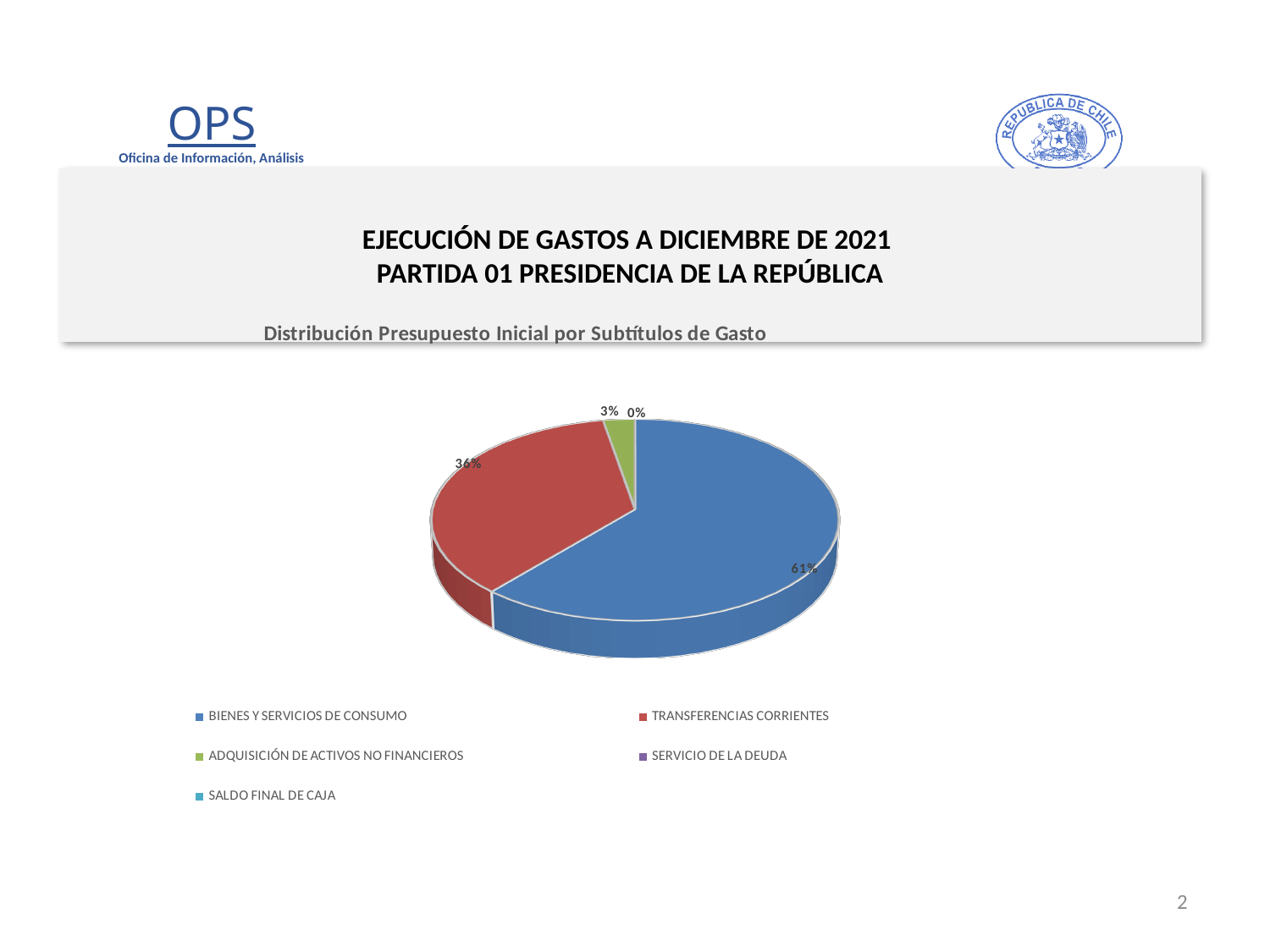
Which category has the largest slice of the pie? BIENES Y SERVICIOS DE CONSUMO What percentage is shown for ADQUISICIÓN DE ACTIVOS NO FINANCIEROS? 3% What is the difference in percentage points between BIENES Y SERVICIOS DE CONSUMO and TRANSFERENCIAS CORRIENTES? 25 percentage points What colour is the slice for BIENES Y SERVICIOS DE CONSUMO? Blue Is the share for BIENES Y SERVICIOS DE CONSUMO greater or less than 50%? greater What percentage is shown for TRANSFERENCIAS CORRIENTES? 36% Which is larger, TRANSFERENCIAS CORRIENTES or ADQUISICIÓN DE ACTIVOS NO FINANCIEROS? TRANSFERENCIAS CORRIENTES What kind of chart is shown on the slide? Pie chart How many categories does the legend list? 5 What share of the pie does BIENES Y SERVICIOS DE CONSUMO represent? 61% What is the title of the chart? Distribución Presupuesto Inicial por Subtítulos de Gasto What is the difference in percentage points between TRANSFERENCIAS CORRIENTES and ADQUISICIÓN DE ACTIVOS NO FINANCIEROS? 33 percentage points